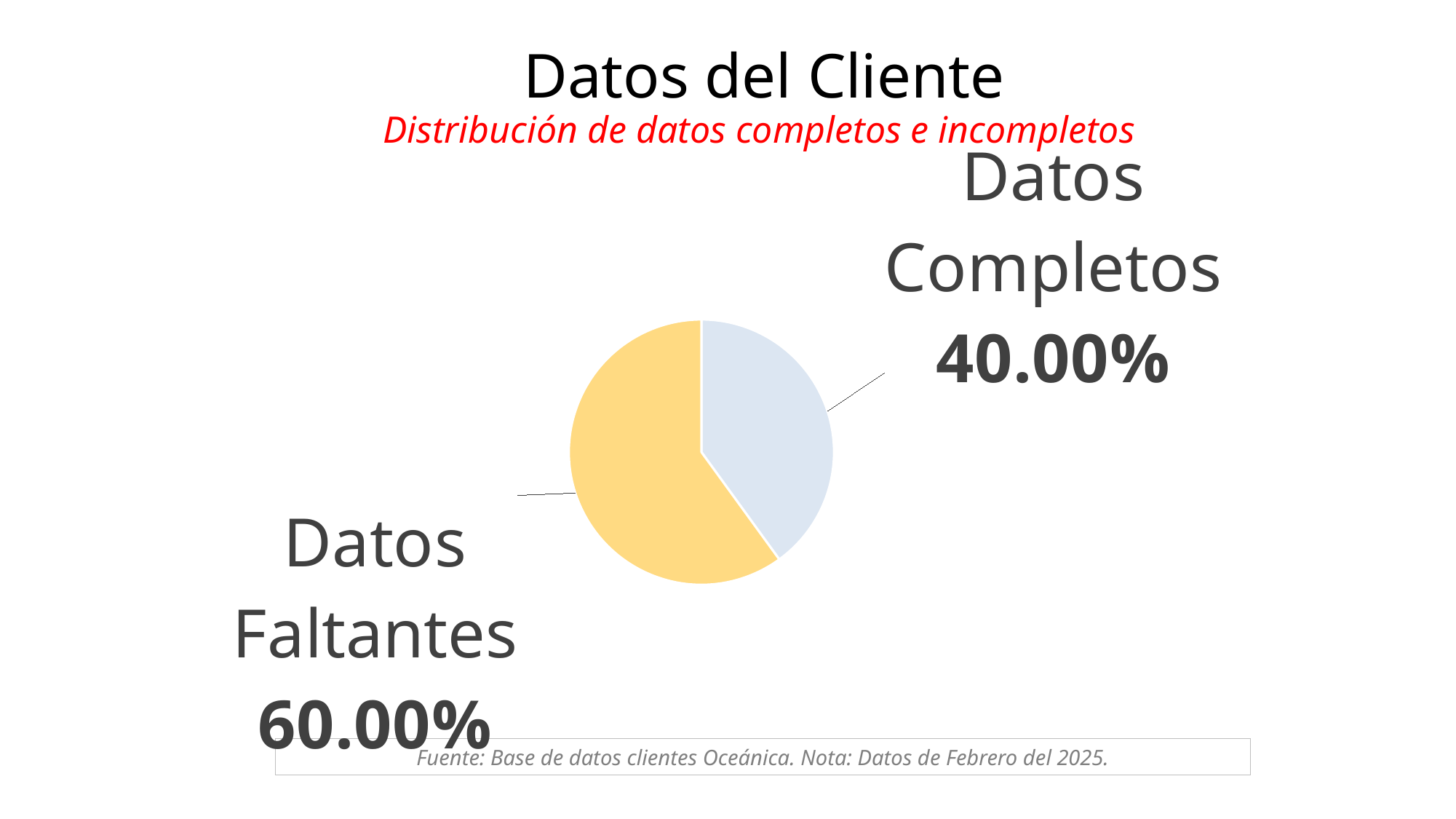
Which slice is the smallest? Datos Completos What is the title of the chart? Datos del Cliente How many slices does the pie chart have? 2 Which is larger, Datos Completos or Datos Faltantes? Datos Faltantes What colour is the Datos Faltantes slice? yellow What share of the pie is labelled Datos Faltantes? 60.00% What is the difference between the Datos Faltantes share and the Datos Completos share? 20.00% What kind of chart is shown on the slide? pie chart Which slice is the largest? Datos Faltantes What share of the pie is labelled Datos Completos? 40.00%